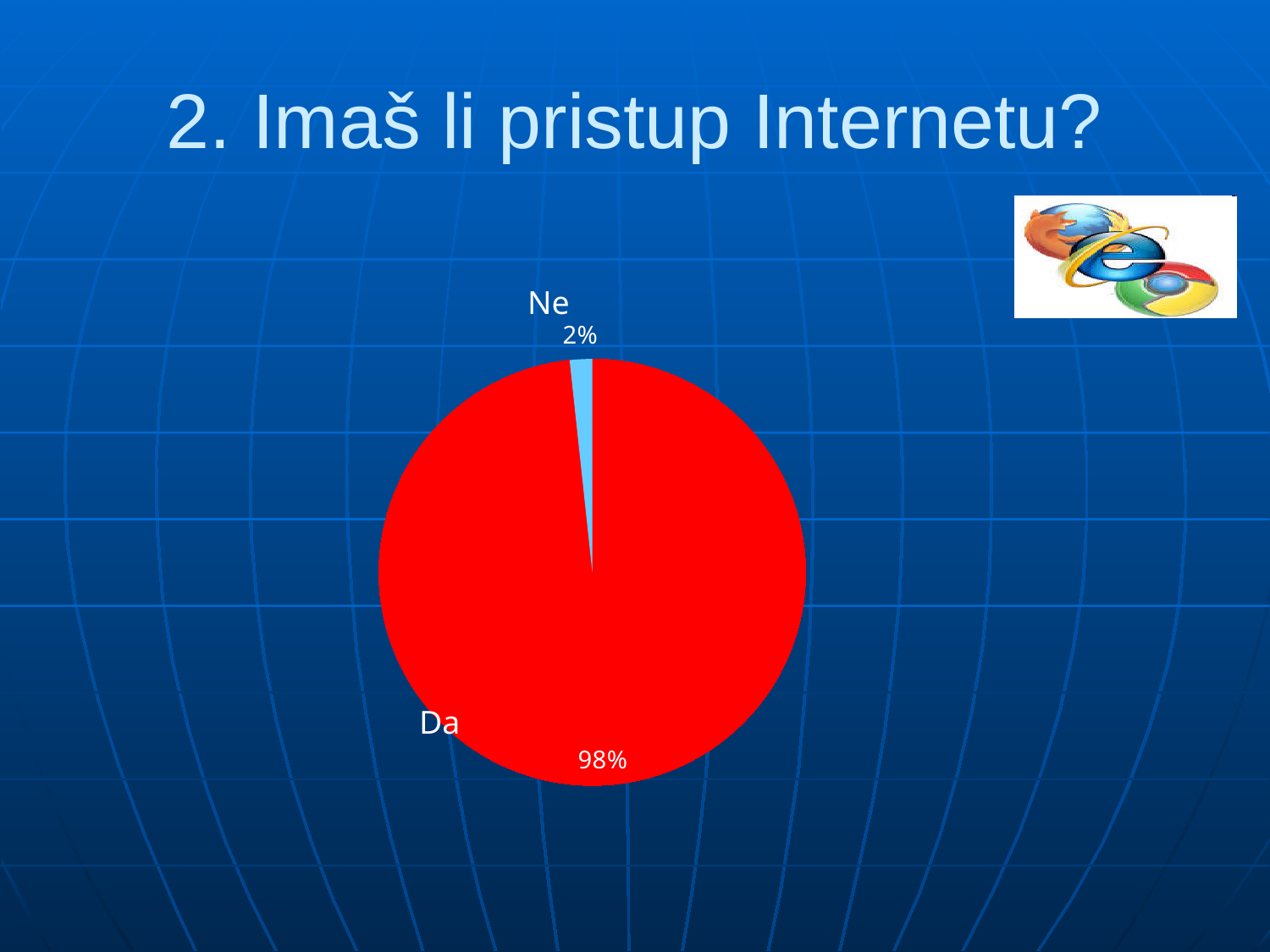
What share of the pie does the "Da" slice represent? 98% Is the share for "Da" greater or less than 50%? greater What is the difference in percentage points between the "Da" and "Ne" slices? 96 Which is larger, the "Da" slice or the "Ne" slice? Da Is the share for "Ne" greater or less than 10%? less Which slice of the pie is the largest? Da How many slices does the pie chart have? 2 What kind of chart is shown on the slide? pie chart What share of the pie does the "Ne" slice represent? 2% Which slice of the pie is the smallest? Ne What colour is the "Ne" slice of the pie? light blue What colour is the "Da" slice of the pie? red